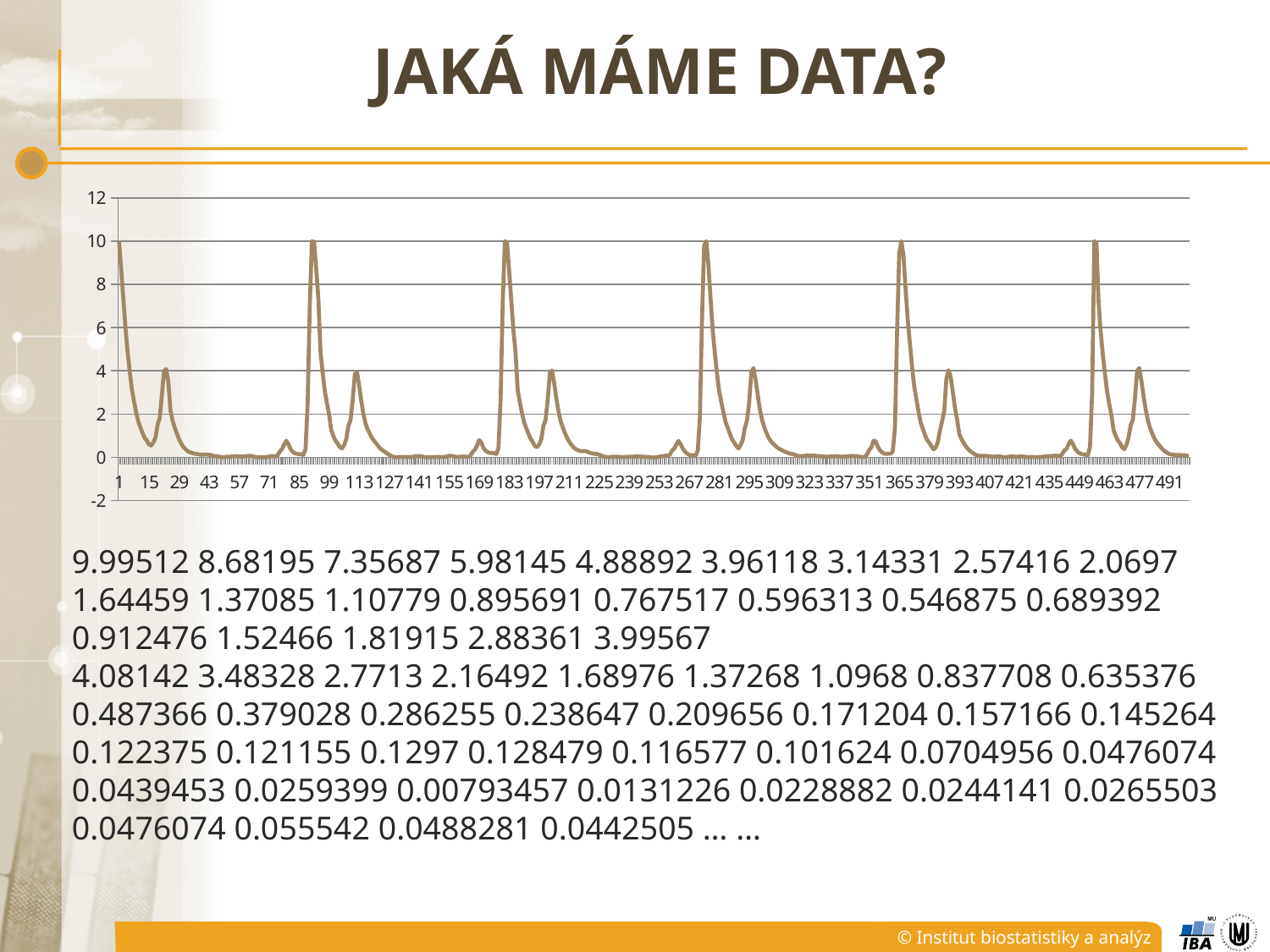
Is the value at the smaller secondary peaks (around x = 29) greater or less than 6? less Is the value at the smaller secondary peaks (around x = 29) greater or less than 2? greater Is the value at the tallest peaks of the line greater or less than 8? greater Which is larger: the value at the peak near x = 85 or the value at the peak near x = 113? the peak near x = 85 What kind of chart is shown on the slide? line chart How many tall peaks reaching about 10 does the line have across the chart? 6 What is the lowest value shown on the y axis of the chart? -2 What is the first x-axis label shown on the chart? 1 What is the last x-axis label shown on the chart? 491 What is the highest value shown on the y axis of the chart? 12